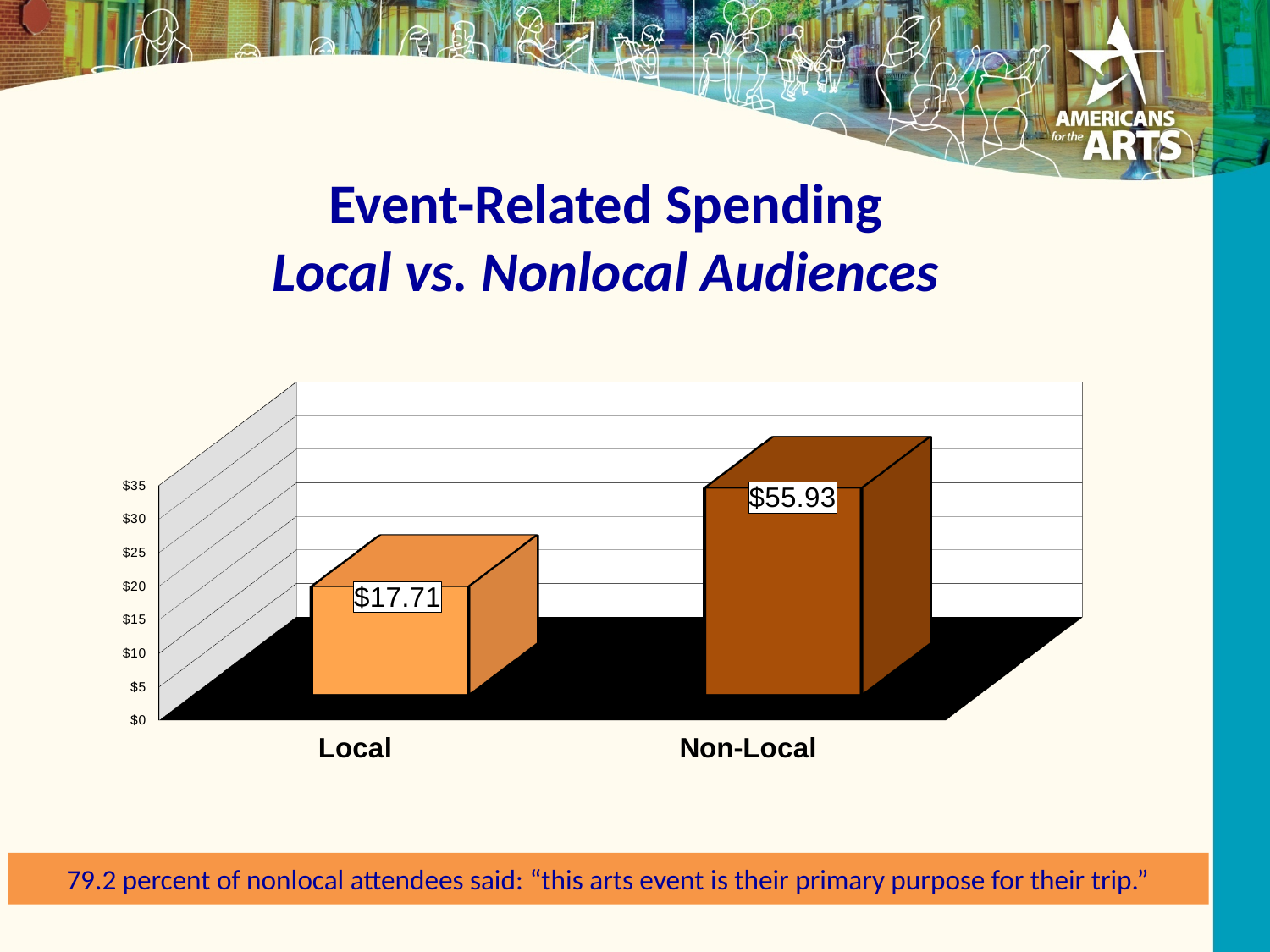
How many categories are shown on the chart? 2 Is the spending for Local audiences larger or smaller than the spending for Non-Local audiences? smaller Which category has the higher event-related spending? Non-Local Which category has the lower event-related spending? Local What are the two category labels on the x axis of the chart? Local and Non-Local What is the event-related spending value shown for Non-Local audiences? $55.93 What is the title of the chart on the slide? Event-Related Spending Local vs. Nonlocal Audiences What is the event-related spending value shown for Local audiences? $17.71 What kind of chart is shown on the slide? bar chart What is the difference in event-related spending between Non-Local and Local audiences? $38.22